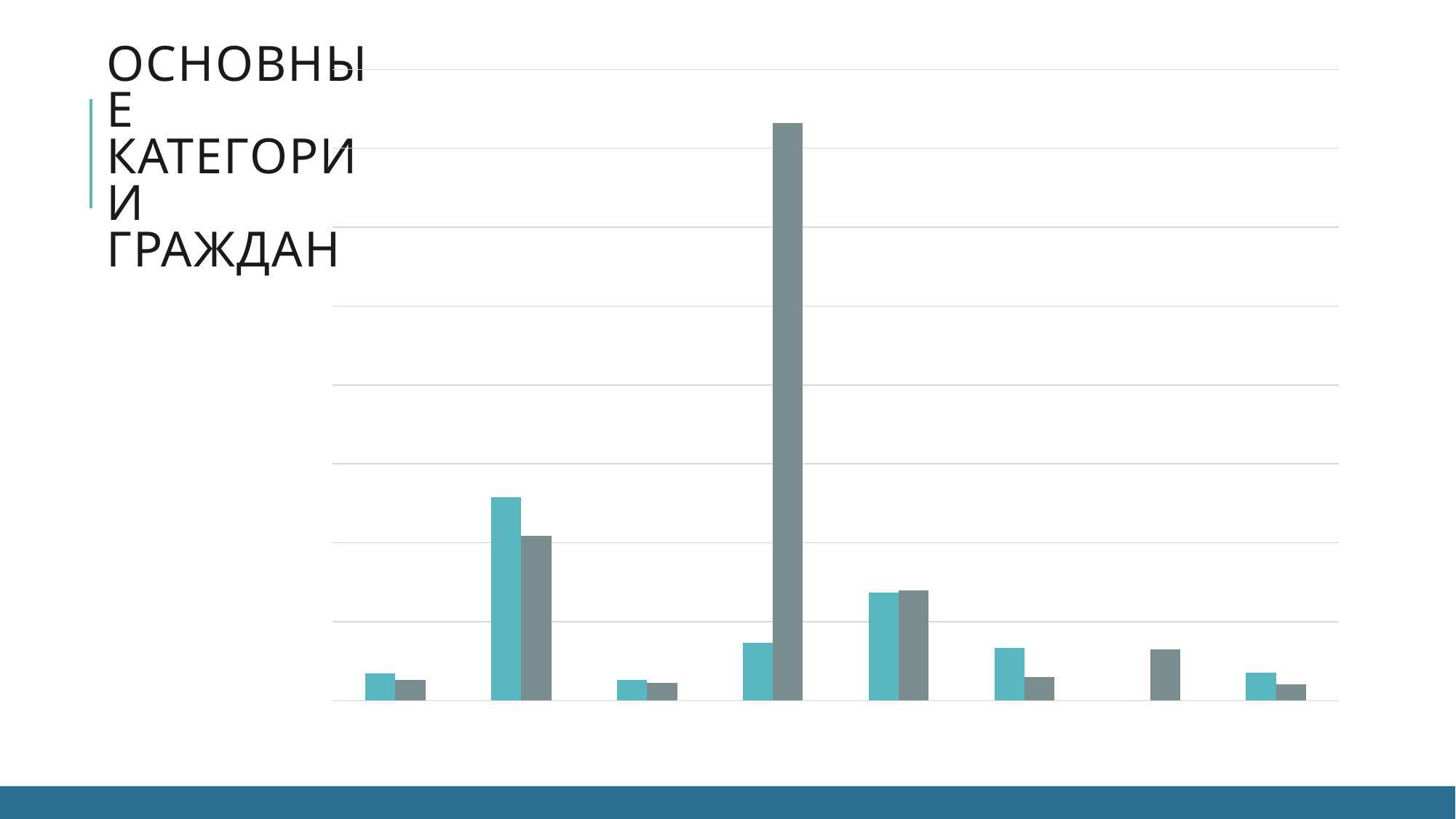
Which group of bars, counted from the left, has only a gray bar and no teal bar? the seventh group In the second group of bars from the left, is the teal bar or the gray bar taller? the teal bar How many different bar colours are used in the chart? 2 What kind of chart is shown on the slide? bar chart In the fourth group of bars from the left, is the teal bar or the gray bar taller? the gray bar In the tallest group of bars, is the tallest bar teal or gray? gray How many groups of bars are plotted along the x axis of the chart? 8 Which group of bars, counted from the left, contains the tallest bar in the chart? the fourth group